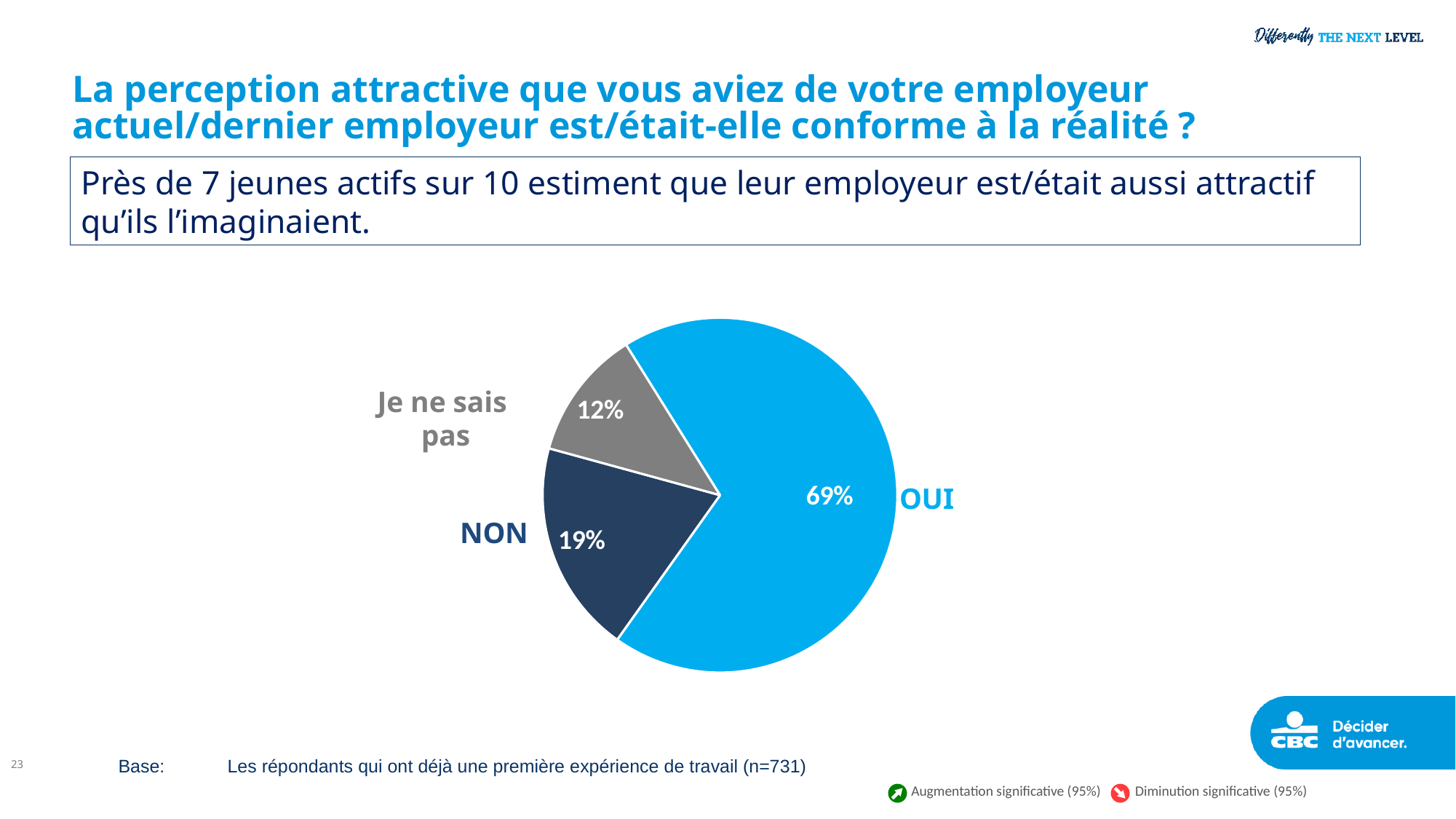
How many slices does the pie chart have? 3 What percentage of respondents answered OUI? 69% Which is larger, the share for NON or the share for Je ne sais pas? NON What colour is the OUI slice of the pie? light blue What kind of chart is shown on the slide? pie chart Which response has the largest share of the pie? OUI What percentage of respondents answered Je ne sais pas? 12% Which response has the smallest share of the pie? Je ne sais pas What is the difference in percentage points between OUI and NON? 50 What is the sample size (n) given in the base note below the chart? 731 What is the difference in percentage points between NON and Je ne sais pas? 7 What percentage of respondents answered NON? 19%